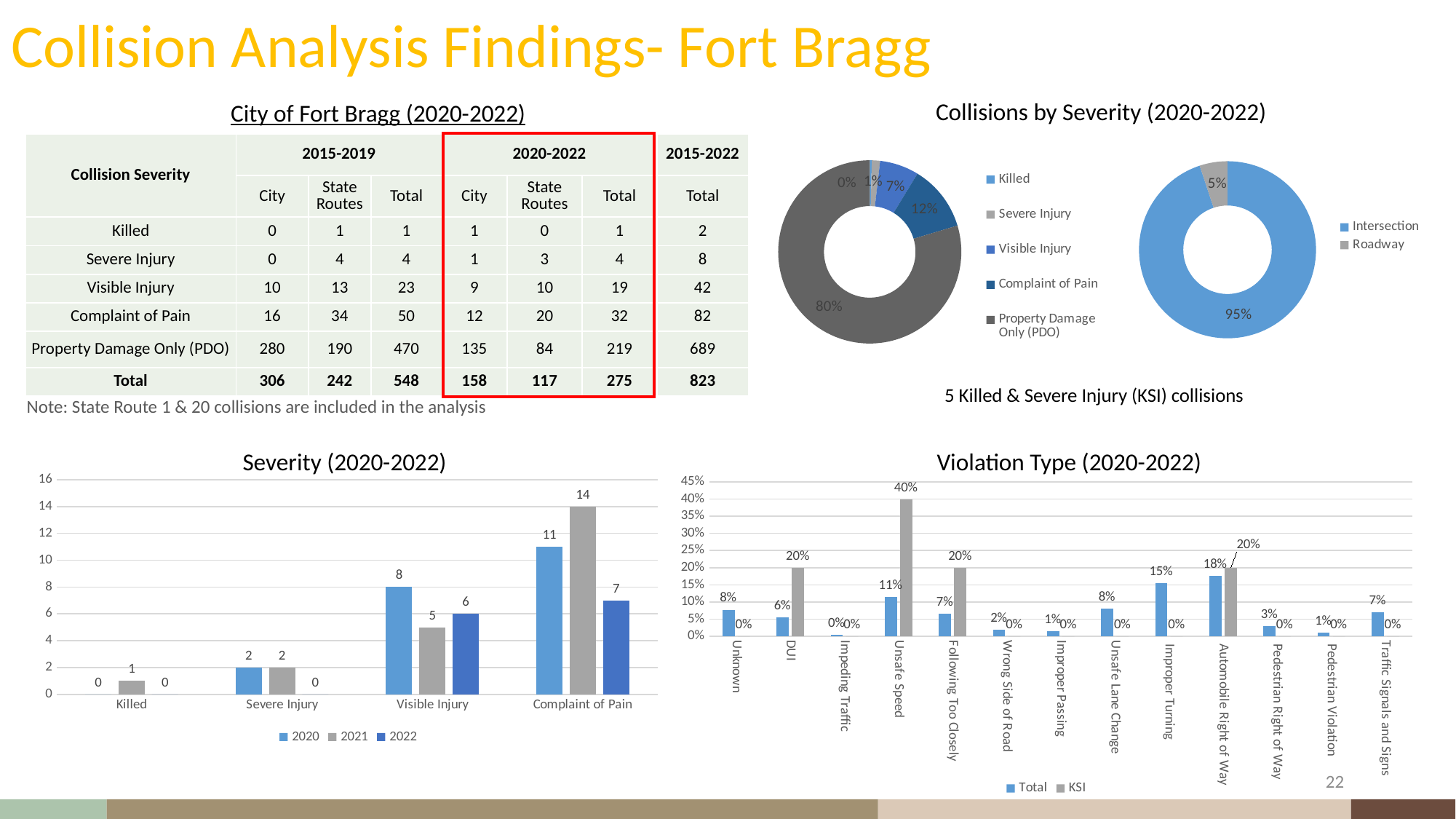
In the Severity (2020-2022) bar chart, what is the difference between the 2020 and 2022 values for Visible Injury? 2 In the Severity (2020-2022) bar chart, which category has the highest value for 2020? Complaint of Pain In the Violation Type (2020-2022) bar chart, what is the KSI value for Unsafe Speed? 40% In the Collisions by Severity donut chart, what share of collisions is Property Damage Only (PDO)? 80% In the Severity (2020-2022) bar chart, what is the value for Complaint of Pain in 2021? 14 In the Violation Type (2020-2022) bar chart, which violation type has the highest Total value? Automobile Right of Way What kind of chart is the Severity (2020-2022) chart? Bar chart How many violation types are shown on the x axis of the Violation Type (2020-2022) bar chart? 13 In the Intersection/Roadway donut chart on the right, what share of collisions occurred at intersections? 95% In the Violation Type (2020-2022) bar chart, which is larger: the Total value for Improper Turning or the Total value for Unsafe Speed? Improper Turning In the Collisions by Severity donut chart, what share of collisions is Complaint of Pain? 12% How many entries does the legend of the Collisions by Severity donut chart list? 5